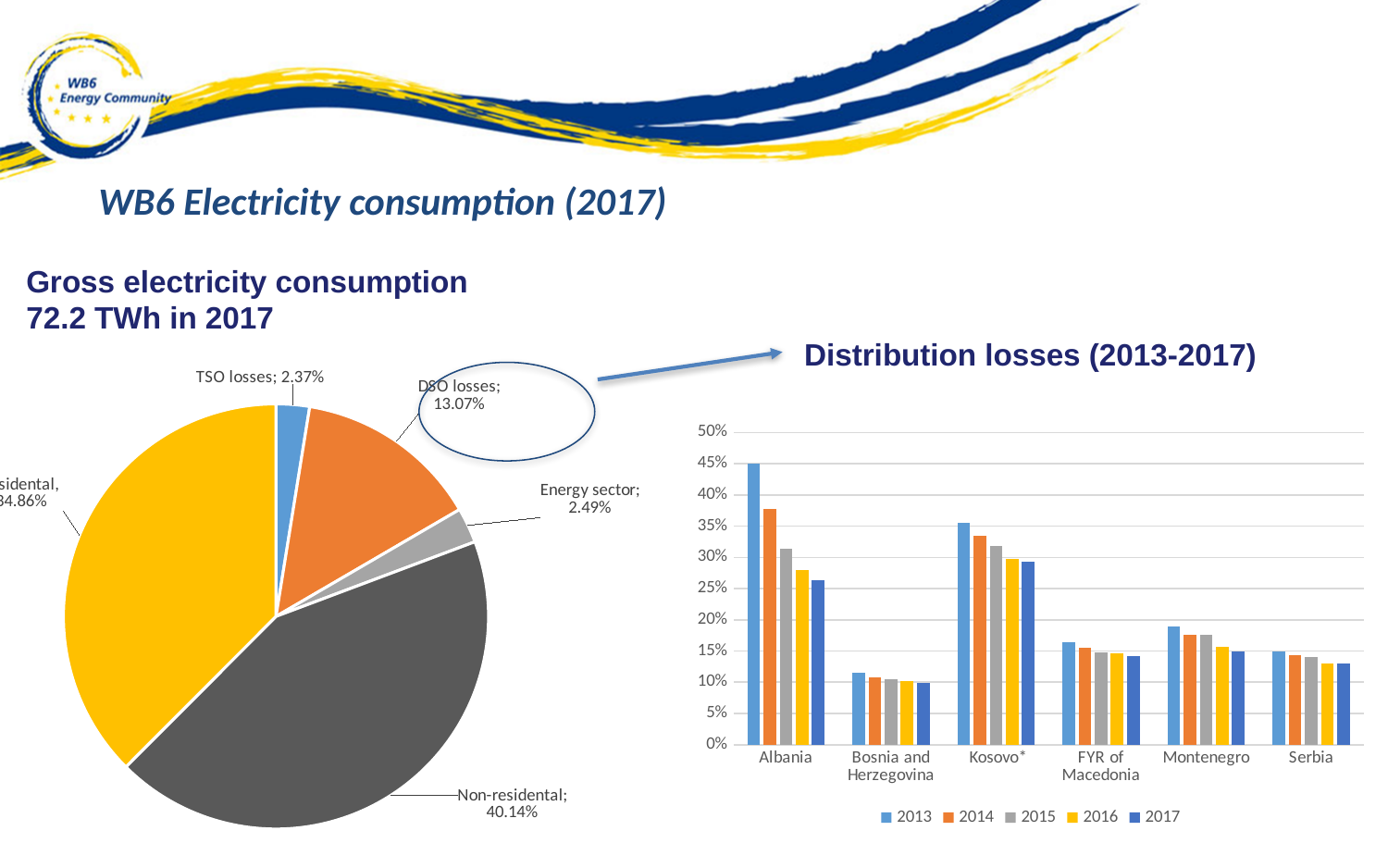
On the Distribution losses (2013-2017) chart, how many countries are shown on the x axis? 6 On the pie chart (Gross electricity consumption), what is the difference between the DSO losses share and the TSO losses share? 10.70% On the pie chart (Gross electricity consumption), what share is labelled for DSO losses? 13.07% On the pie chart (Gross electricity consumption), which labelled slice is the largest? Non-residential On the Distribution losses (2013-2017) chart, what kind of chart is shown? bar chart On the Distribution losses (2013-2017) chart, how many series does the legend list? 5 On the Distribution losses (2013-2017) chart, do Albania's distribution losses rise or fall from 2013 to 2017? fall On the pie chart (Gross electricity consumption), what share is labelled for Non-residential? 40.14% On the Distribution losses (2013-2017) chart, is the value for Albania in 2017 greater or less than 25%? greater On the pie chart (Gross electricity consumption), what share is labelled for TSO losses? 2.37% On the pie chart (Gross electricity consumption), what share is labelled for Energy sector? 2.49% On the Distribution losses (2013-2017) chart, which country has the highest distribution losses in 2013? Albania